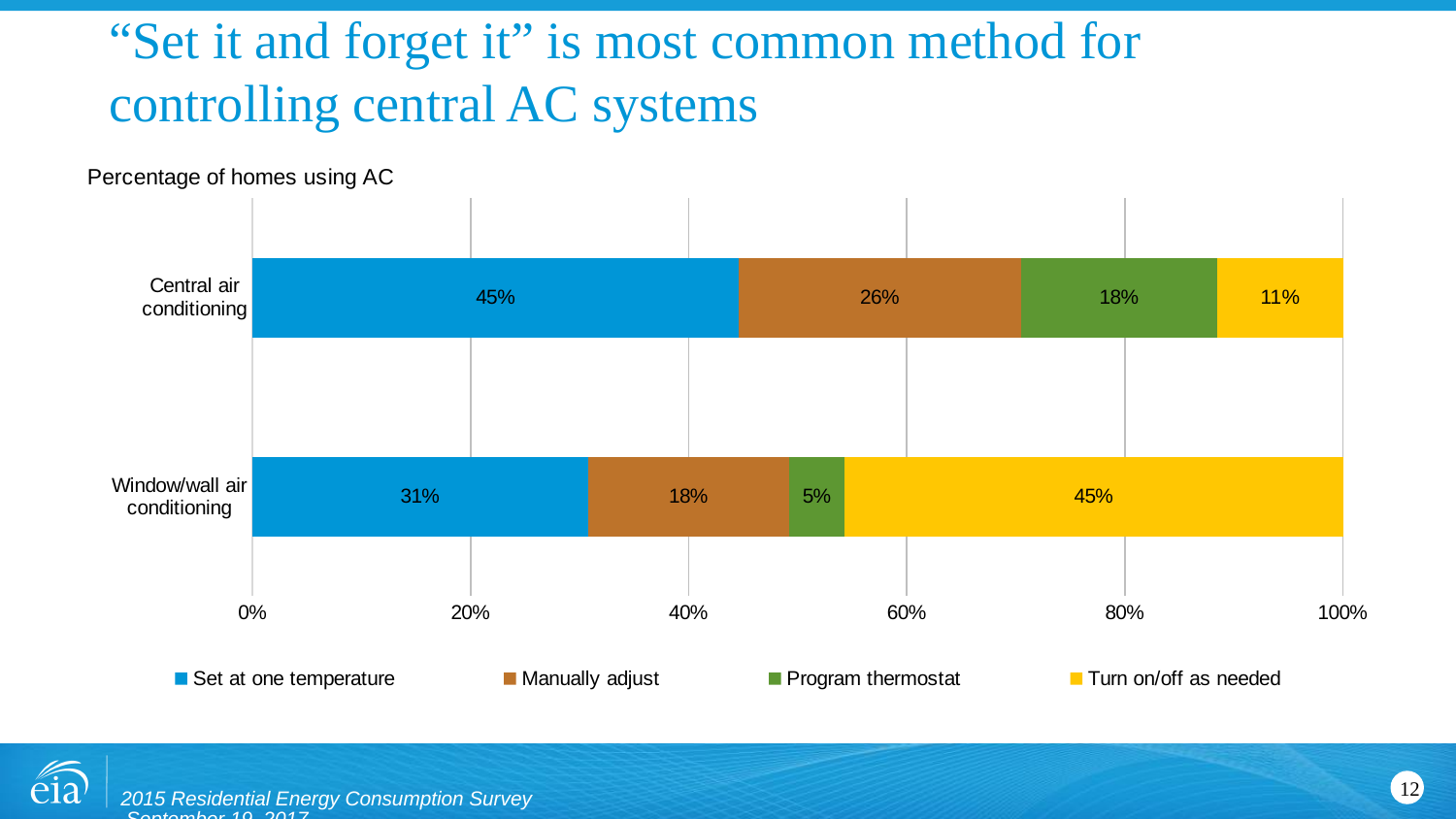
What colour represents 'Turn on/off as needed' in the chart? Yellow What percentage of homes with central air conditioning manually adjust? 26% What is the difference between the share of central AC homes that program the thermostat and the share of window/wall AC homes that do? 13% Which is larger: the share of central AC homes that turn it on/off as needed, or the share of window/wall AC homes that do? Window/wall air conditioning Which control method is the least common for window/wall air conditioning? Program thermostat How many series does the legend list? 4 What percentage of homes with window/wall air conditioning program the thermostat? 5% Which control method is the most common for central air conditioning? Set at one temperature What percentage of homes with window/wall air conditioning turn it on/off as needed? 45% What percentage of homes with central air conditioning set it at one temperature? 45% How many AC types (categories) are shown on the chart? 2 What kind of chart is shown on the slide? Stacked bar chart